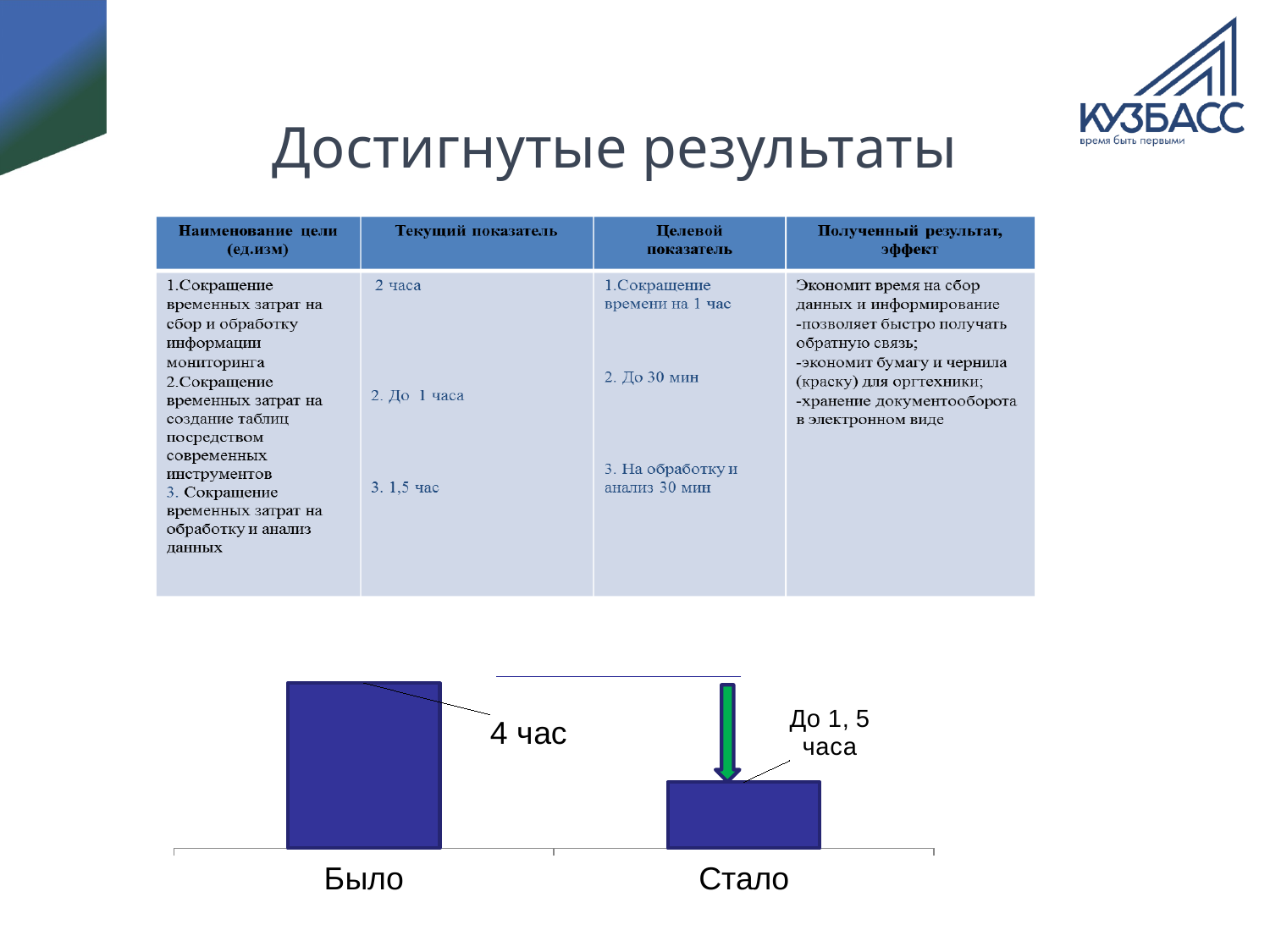
What kind of chart is shown at the bottom of the slide? bar chart Which category has the tallest bar? Было What are the two category labels on the x axis of the chart? Было, Стало What value is labelled for the "Было" bar? 4 час What colour are the bars in the chart? blue Which category has the shortest bar? Стало What value is labelled for the "Стало" bar? До 1, 5 часа Which bar is taller, "Было" or "Стало"? Было Do the bar values rise or fall from "Было" to "Стало"? fall How many bars does the chart at the bottom of the slide have? 2